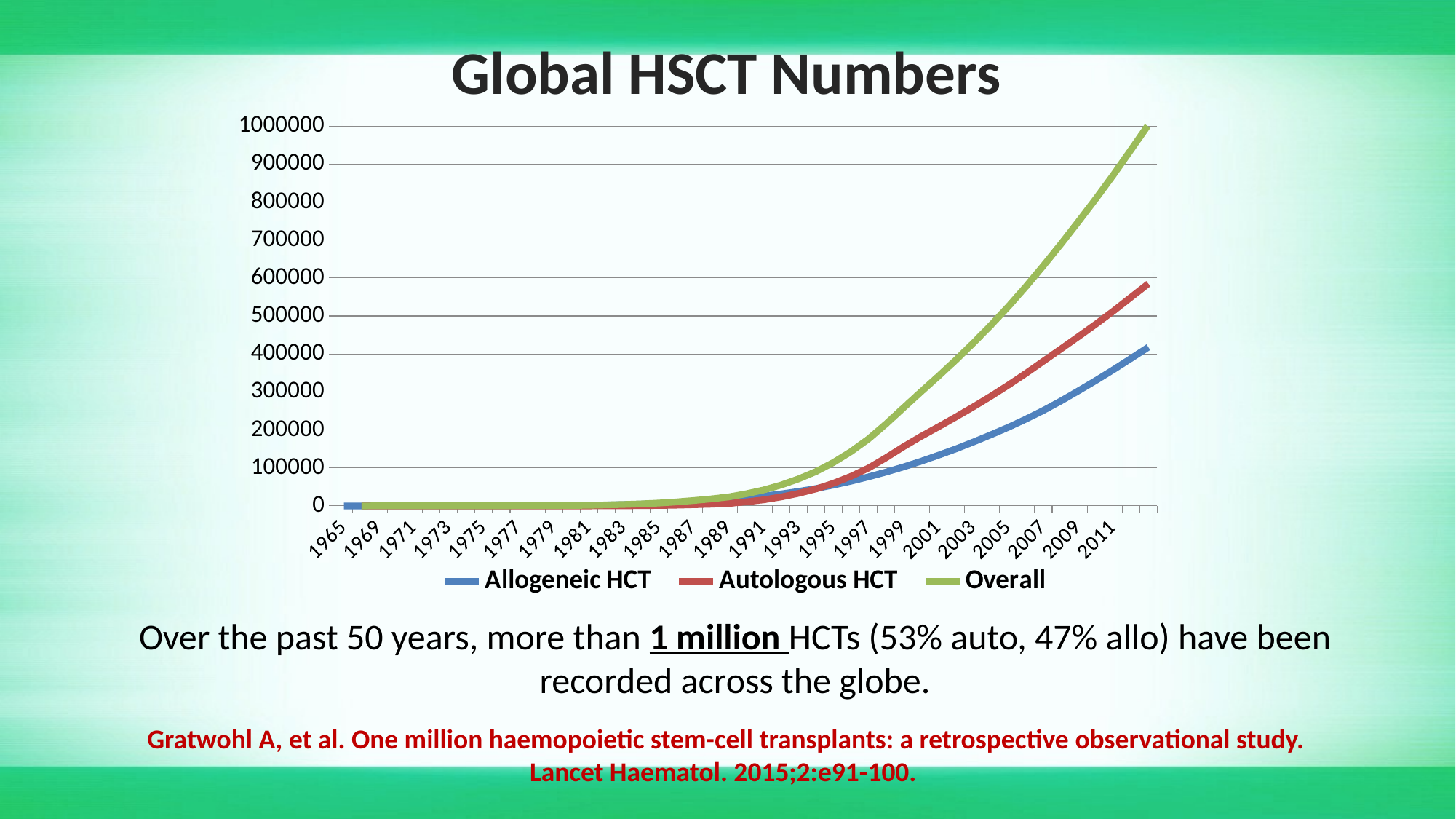
Is the value for Allogeneic HCT in 1985 greater or less than 100000? less What is the title of the chart? Global HSCT Numbers Do the Overall values rise or fall from 1965 to 2011? rise Is the value for Autologous HCT in 2011 greater or less than 400000? greater Which series has the lowest value at the right end of the chart? Allogeneic HCT How many series does the legend list? 3 Is the value for Overall in 2011 greater or less than 600000? greater What kind of chart is shown on the slide? line chart Which series is drawn in green? Overall In 2011, which is larger: Autologous HCT or Allogeneic HCT? Autologous HCT Which series has the highest value at the right end of the chart? Overall